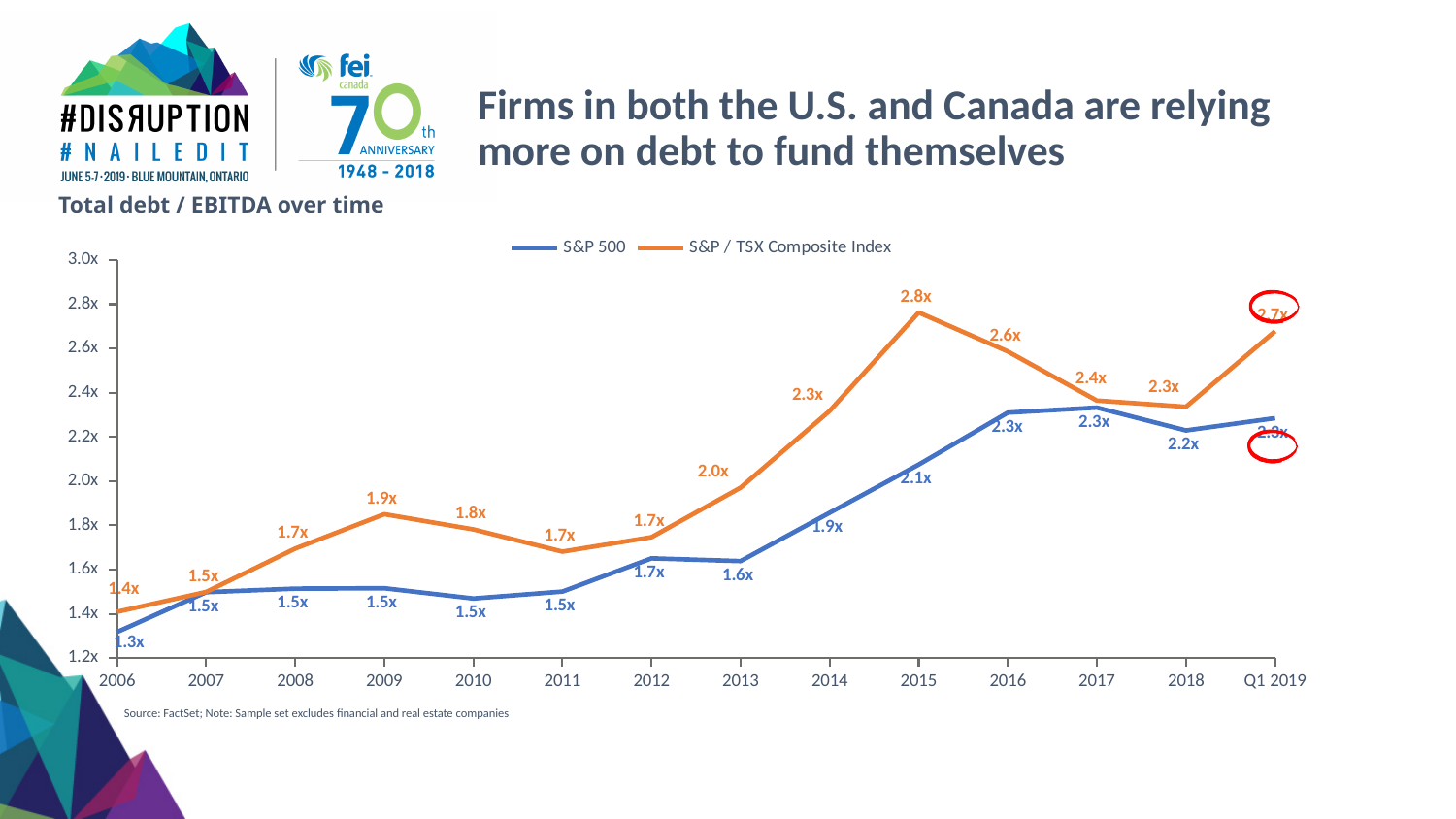
What is the S&P / TSX Composite Index value in Q1 2019? 2.7x In which year is the S&P 500 value lowest? 2006 In which year does the S&P / TSX Composite Index reach its highest value? 2015 How many time points are plotted on the x axis? 14 How many series does the legend list? 2 What is the S&P / TSX Composite Index value in 2015? 2.8x Which series has the higher value in 2009, S&P 500 or S&P / TSX Composite Index? S&P / TSX Composite Index What is the S&P 500 value in 2006? 1.3x What is the title of the chart? Total debt / EBITDA over time What is the difference between the S&P / TSX Composite Index and the S&P 500 in 2015? 0.7x What is the S&P 500 value in 2018? 2.2x What type of chart is shown on the slide? Line chart